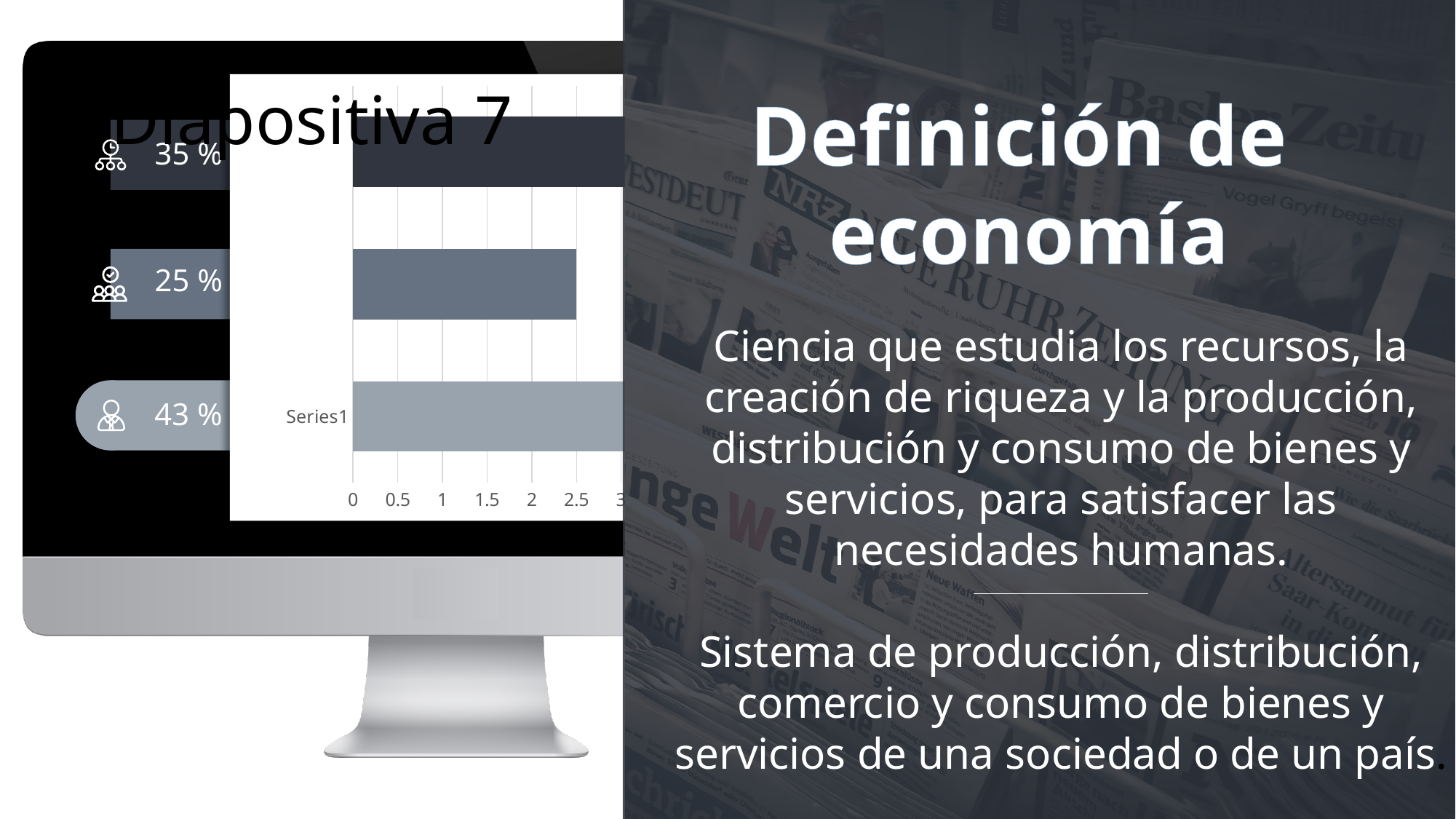
Is the value for Series1 greater or less than 2.5? greater What is the step between consecutive tick labels on the horizontal axis? 0.5 What value does the middle bar of the chart reach on the horizontal axis? 2.5 Which category label is readable on the chart's vertical axis? Series1 Which of the three bars is the shortest? the middle bar Which is larger, the Series1 bar or the middle bar? Series1 Is the value of the middle bar greater or less than 3? less What kind of chart is shown on the monitor screen? bar chart Is the value for Series1 greater or less than 2? greater How many bars are visible in the chart on the monitor? 3